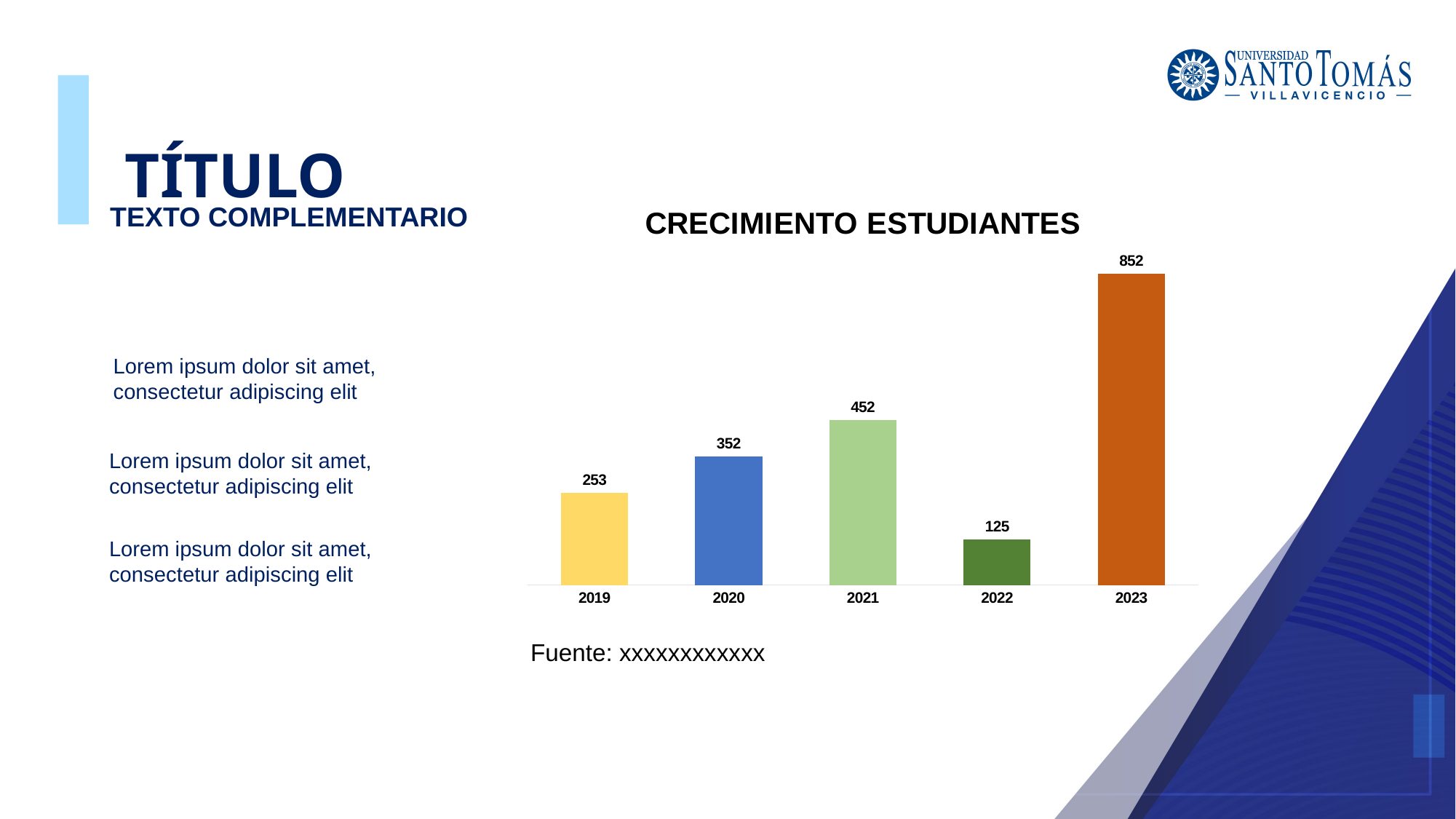
Which year has the highest value? 2023 What is the value for 2022? 125 What is the value for 2019? 253 What kind of chart is shown? Bar chart How many years are shown on the x axis? 5 What is the value for 2021? 452 Which year has the lowest value? 2022 What is the difference between the values for 2020 and 2019? 99 Which is larger, the value for 2020 or the value for 2022? 2020 What is the difference between the values for 2023 and 2021? 400 What colour is the bar for 2023? Orange What is the title of the chart? CRECIMIENTO ESTUDIANTES